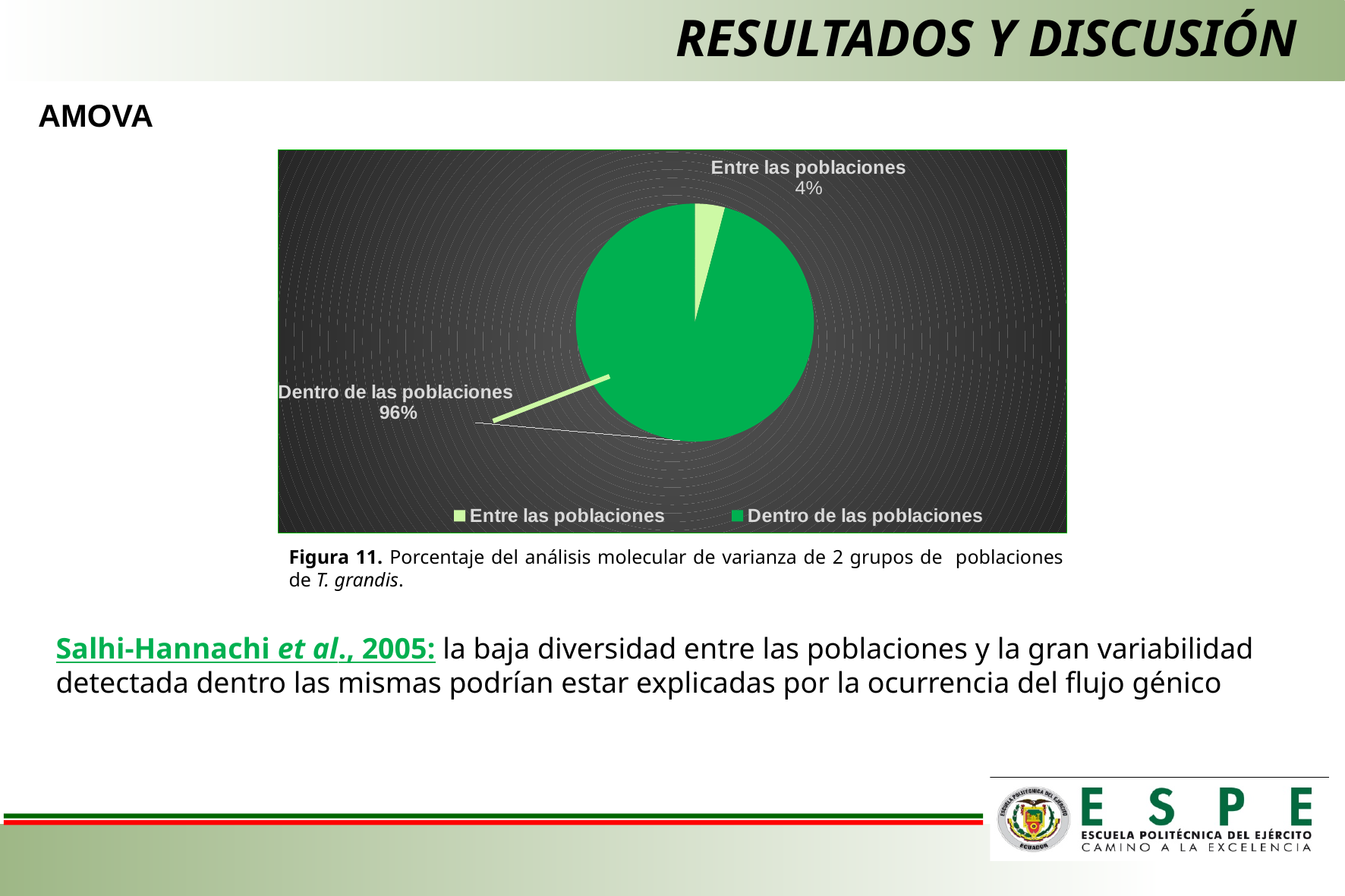
What colour is the 'Dentro de las poblaciones' slice? green What kind of chart is shown on the slide? pie chart What percentage does the 'Entre las poblaciones' slice represent? 4% How many entries does the legend list? 2 What is the difference in percentage points between 'Dentro de las poblaciones' and 'Entre las poblaciones'? 92 Which slice of the pie is the largest? Dentro de las poblaciones Which slice of the pie is the smallest? Entre las poblaciones What is the figure number given in the caption below the chart? Figura 11 How many slices does the pie chart have? 2 Which is larger, 'Entre las poblaciones' or 'Dentro de las poblaciones'? Dentro de las poblaciones What percentage does the 'Dentro de las poblaciones' slice represent? 96% What share of the pie does 'Entre las poblaciones' take? 4%